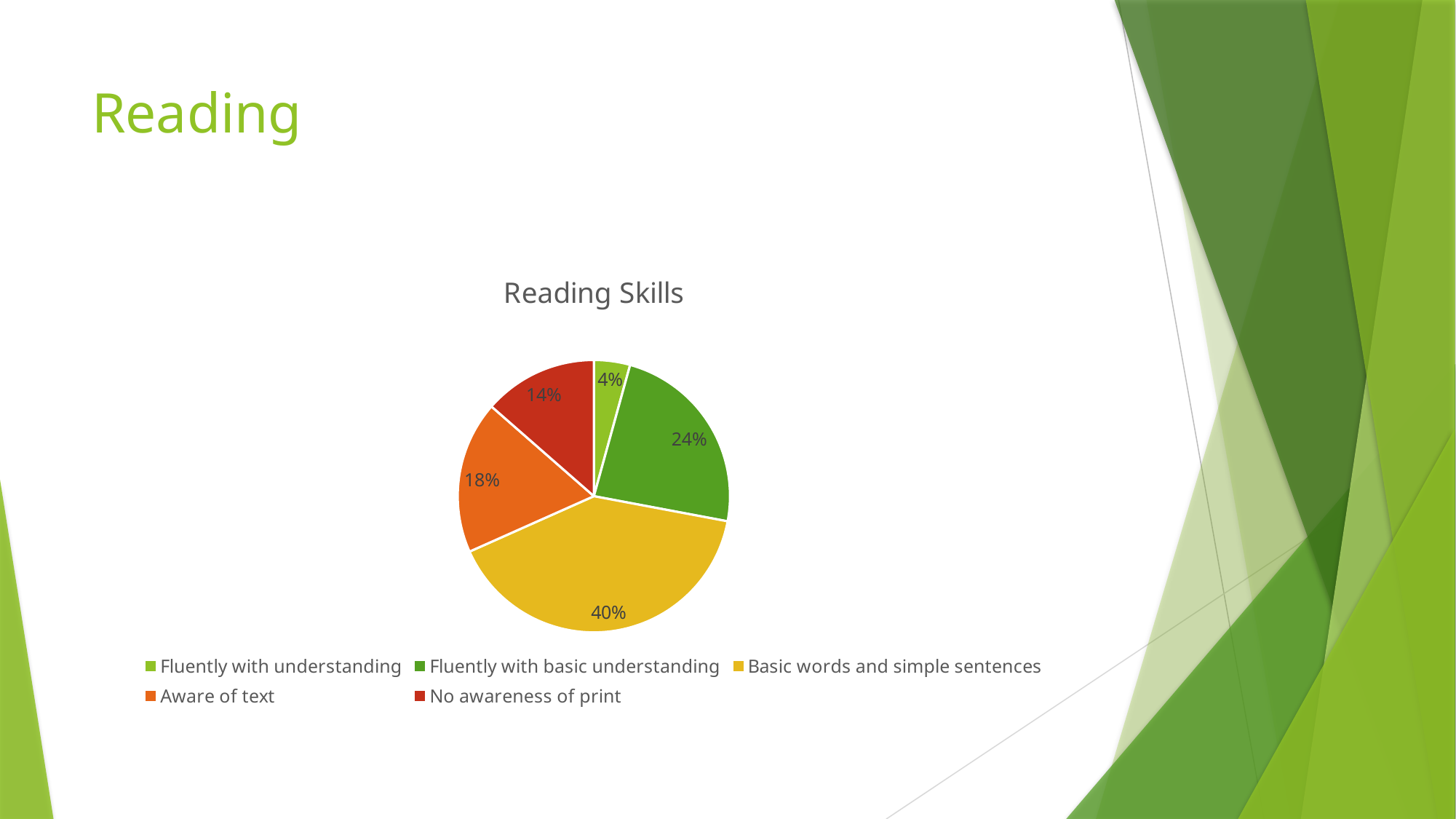
What type of chart is shown on the slide? Pie chart What percentage of the pie is 'Aware of text'? 18% What percentage of the pie is 'Fluently with understanding'? 4% Which category has the smallest share of the pie? Fluently with understanding How many categories does the pie chart have? 5 What colour is the slice for 'No awareness of print'? Red What is the title of the chart? Reading Skills Which category has the largest share of the pie? Basic words and simple sentences What is the difference between the shares for 'Fluently with basic understanding' and 'Aware of text'? 6% What percentage of the pie is 'No awareness of print'? 14% What percentage of the pie is 'Basic words and simple sentences'? 40% Which is larger: the share for 'Aware of text' or the share for 'No awareness of print'? Aware of text